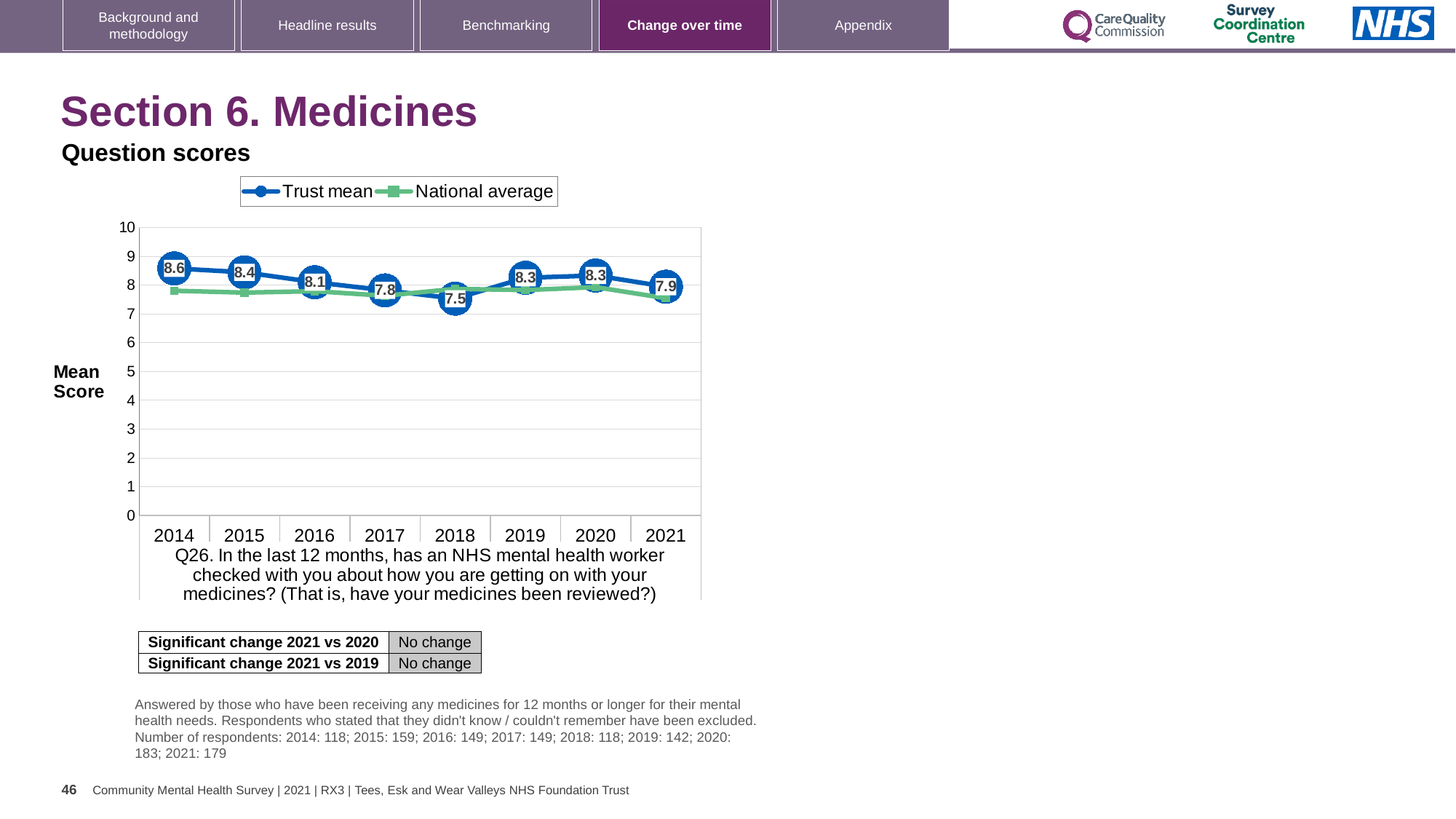
Is the National average value for 2018 greater or less than 7? greater What is the Trust mean score for 2014? 8.6 What is the difference between the Trust mean score in 2014 and in 2018? 1.1 In which year is the Trust mean score highest? 2014 How many series does the legend list? 2 What type of chart is shown on the slide? Line chart What is the Trust mean score for 2018? 7.5 Does the Trust mean score rise or fall from 2014 to 2018? Fall How many years are plotted on the x axis? 8 Which year has a higher Trust mean score, 2016 or 2019? 2019 In which year is the Trust mean score lowest? 2018 What is the Trust mean score for 2021? 7.9